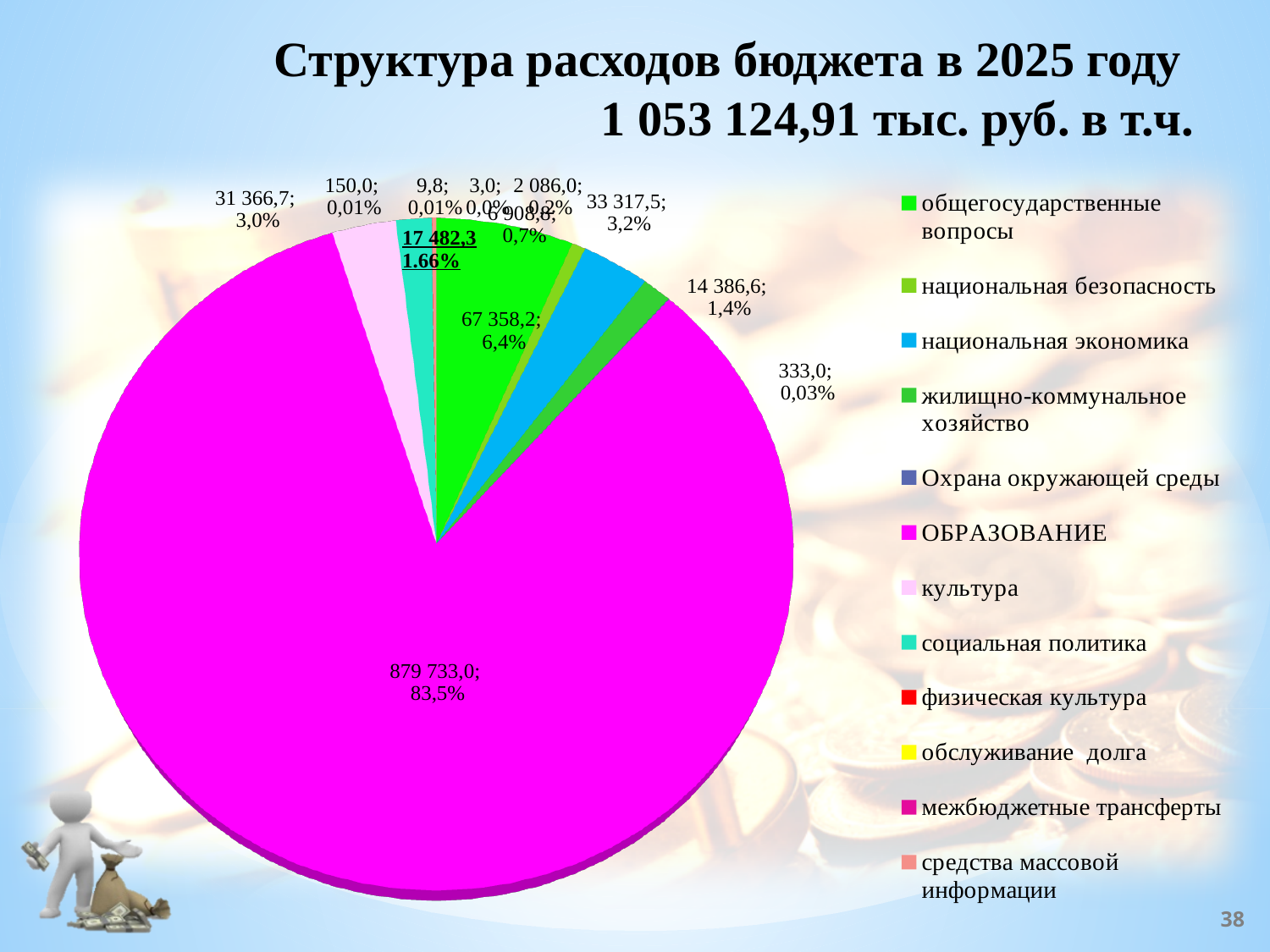
What share of the pie does общегосударственные вопросы take? 6,4% What total amount is stated in the chart title? 1 053 124,91 тыс. руб. What kind of chart is shown on the slide? pie chart What value is shown for общегосударственные вопросы? 67 358,2 What value is shown for культура? 31 366,7 What is the difference between the values for ОБРАЗОВАНИЕ and общегосударственные вопросы? 812 374,8 How many categories does the legend list? 12 What value is shown for ОБРАЗОВАНИЕ? 879 733,0 What share of the pie does ОБРАЗОВАНИЕ take? 83,5% Which is larger, the slice for ОБРАЗОВАНИЕ or the slice for общегосударственные вопросы? ОБРАЗОВАНИЕ Which category has the largest slice of the pie? ОБРАЗОВАНИЕ What share of the pie does социальная политика take? 1.66%